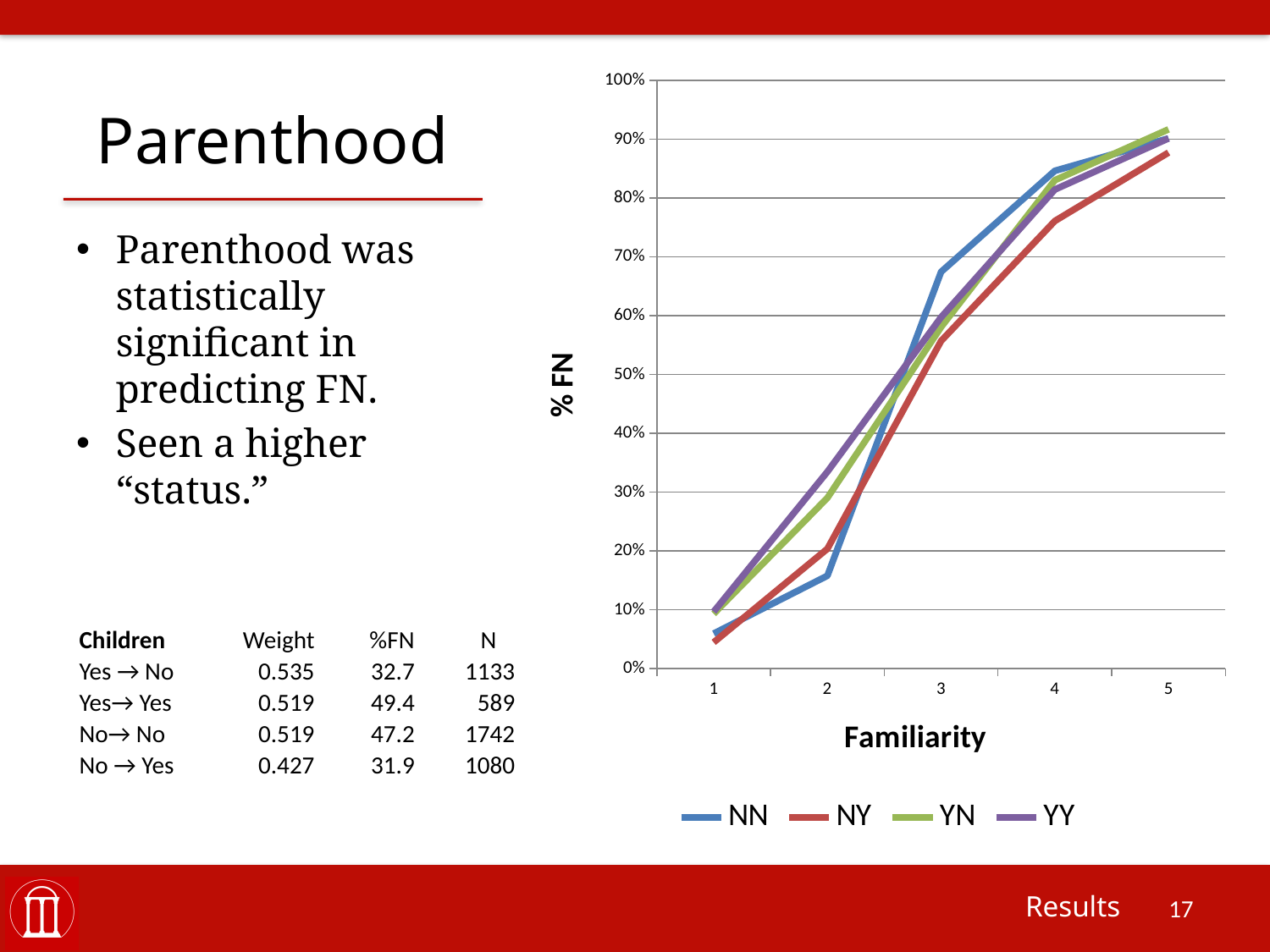
Is the value for NN at Familiarity 2 greater or less than 20%? less Which series has the lowest % FN at Familiarity 4? NY Is the value for NN at Familiarity 3 greater or less than 60%? greater Do the % FN values rise or fall as Familiarity increases from 1 to 5? rise How many series does the chart legend list? 4 What kind of chart is shown on the slide? line chart How many Familiarity levels are plotted along the x axis? 5 Which series has the highest % FN at Familiarity 3? NN Is the value for YY at Familiarity 2 greater or less than 30%? greater What is the title of the chart's x axis? Familiarity At Familiarity 2, which series has the larger value, YY or NN? YY